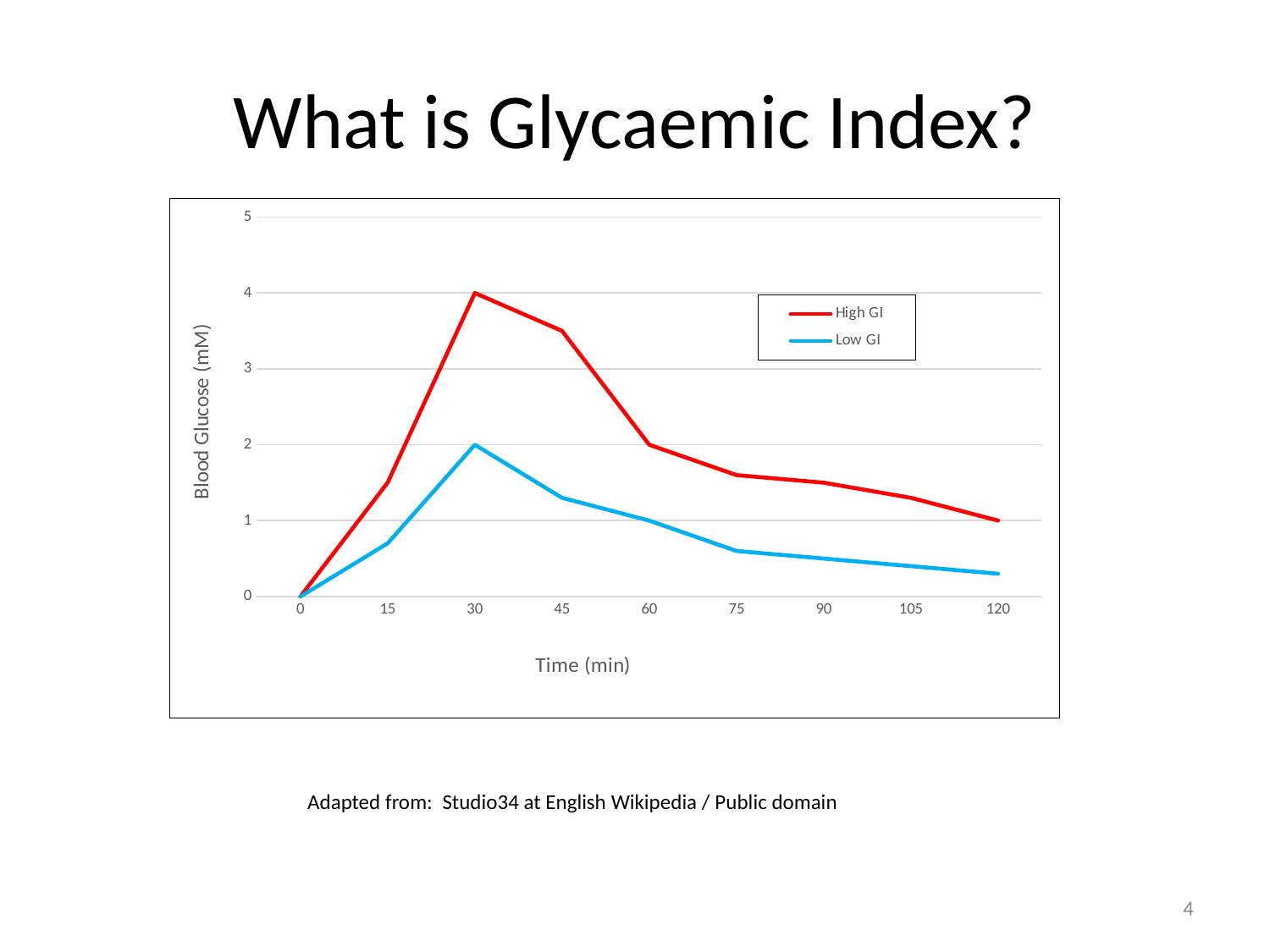
What is the blood glucose value for Low GI at 30 min? 2 What is the blood glucose value for High GI at 120 min? 1 Is the value for Low GI at 75 min greater or less than 1? less Is the value for High GI at 45 min greater or less than 3? greater At which time does the High GI series reach its highest value? 30 How many series does the legend list? 2 What is the blood glucose value for High GI at 30 min? 4 How many time points are marked on the x axis? 9 What is the blood glucose value for High GI at 60 min? 2 What kind of chart is shown on the slide? line chart Which series has the larger value at 45 min, High GI or Low GI? High GI What is the difference between the High GI and Low GI values at 30 min? 2